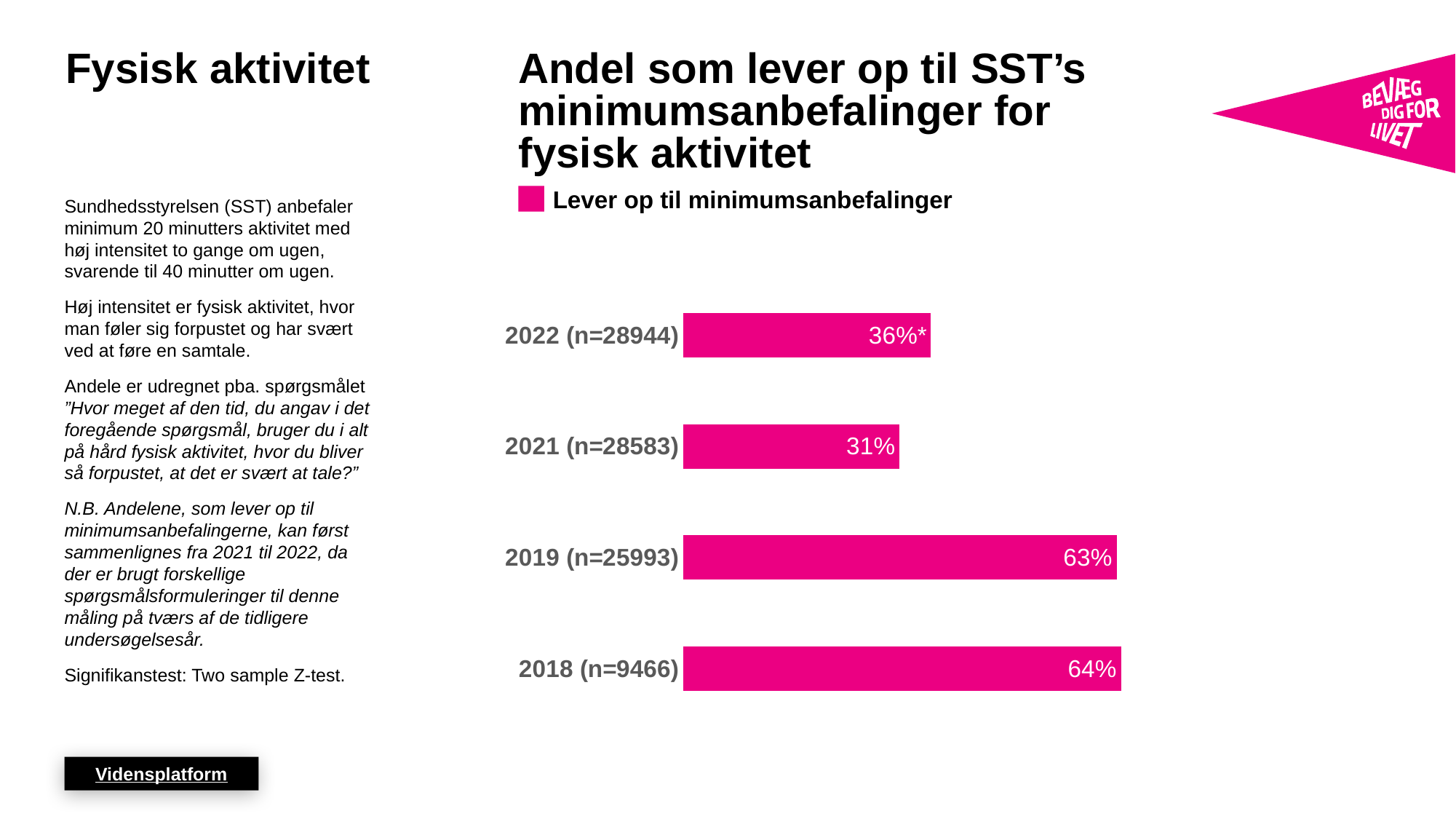
What is the value for 2022 (n=28944)? 36%* What is the value for 2021 (n=28583)? 31% How many years (categories) are shown in the chart? 4 What is the difference between the values for 2018 and 2019? 1 percentage point What kind of chart is shown on the slide? Bar chart What is the difference between the values for 2022 and 2021? 5 percentage points Which year has the lowest share meeting the minimum recommendations? 2021 (n=28583) Which is larger, the value for 2019 or the value for 2022? 2019 What is the legend entry shown for the chart? Lever op til minimumsanbefalinger What is the value for 2019 (n=25993)? 63% Which year has the highest share meeting the minimum recommendations? 2018 (n=9466) What is the value for 2018 (n=9466)? 64%